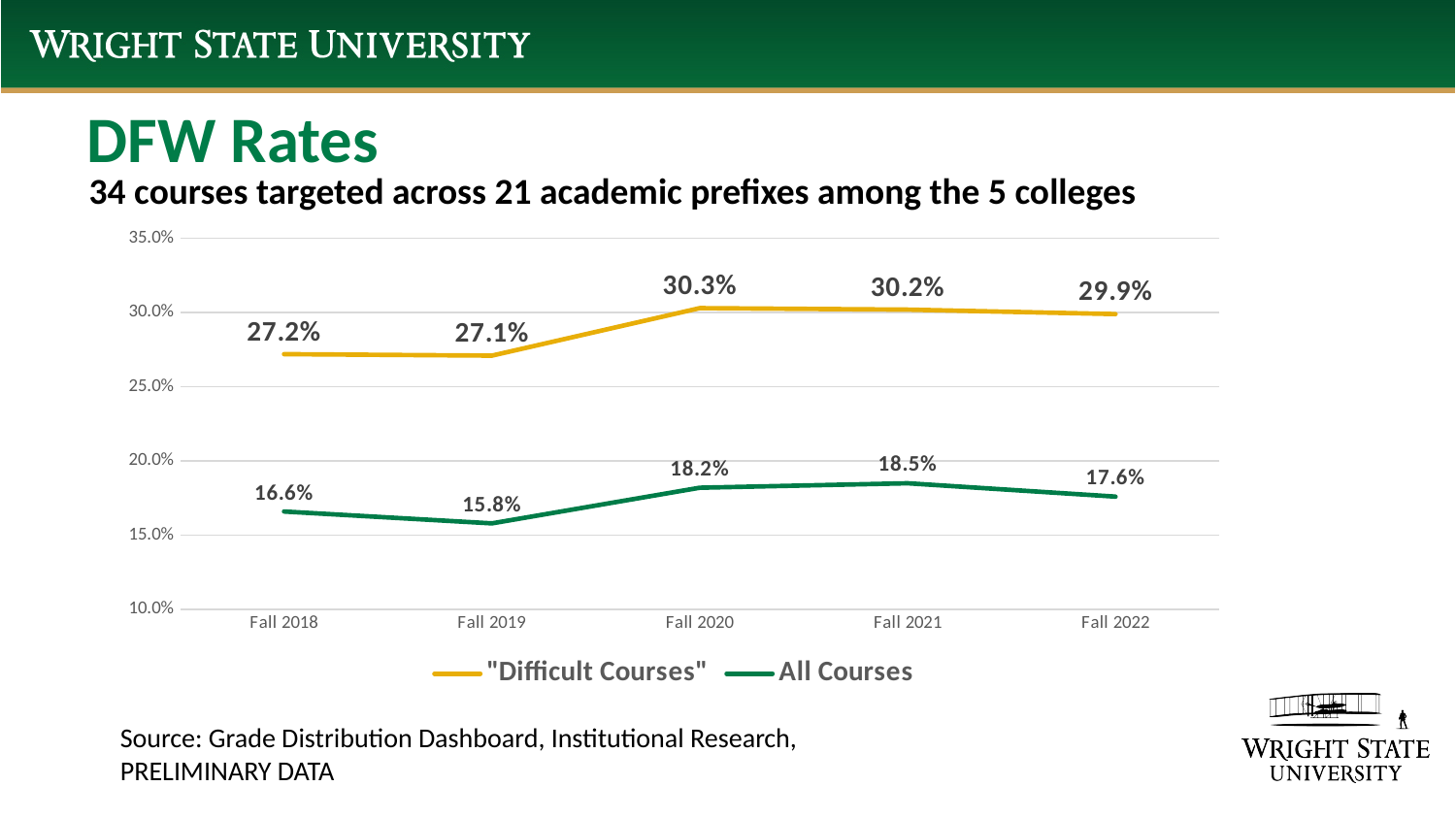
In which term is the All Courses DFW rate lowest? Fall 2019 What is the difference between the "Difficult Courses" and All Courses DFW rates in Fall 2021? 11.7% What is the DFW rate for All Courses in Fall 2022? 17.6% In which term is the "Difficult Courses" DFW rate highest? Fall 2020 What is the title of the slide's chart section? DFW Rates Is the "Difficult Courses" DFW rate in Fall 2018 greater or less than 30.0%? less What is the DFW rate for All Courses in Fall 2019? 15.8% What kind of chart is shown on the slide? line chart How many series does the legend list? 2 How many terms are shown on the x axis? 5 Which is larger: the All Courses DFW rate in Fall 2020 or in Fall 2022? Fall 2020 What is the DFW rate for "Difficult Courses" in Fall 2020? 30.3%